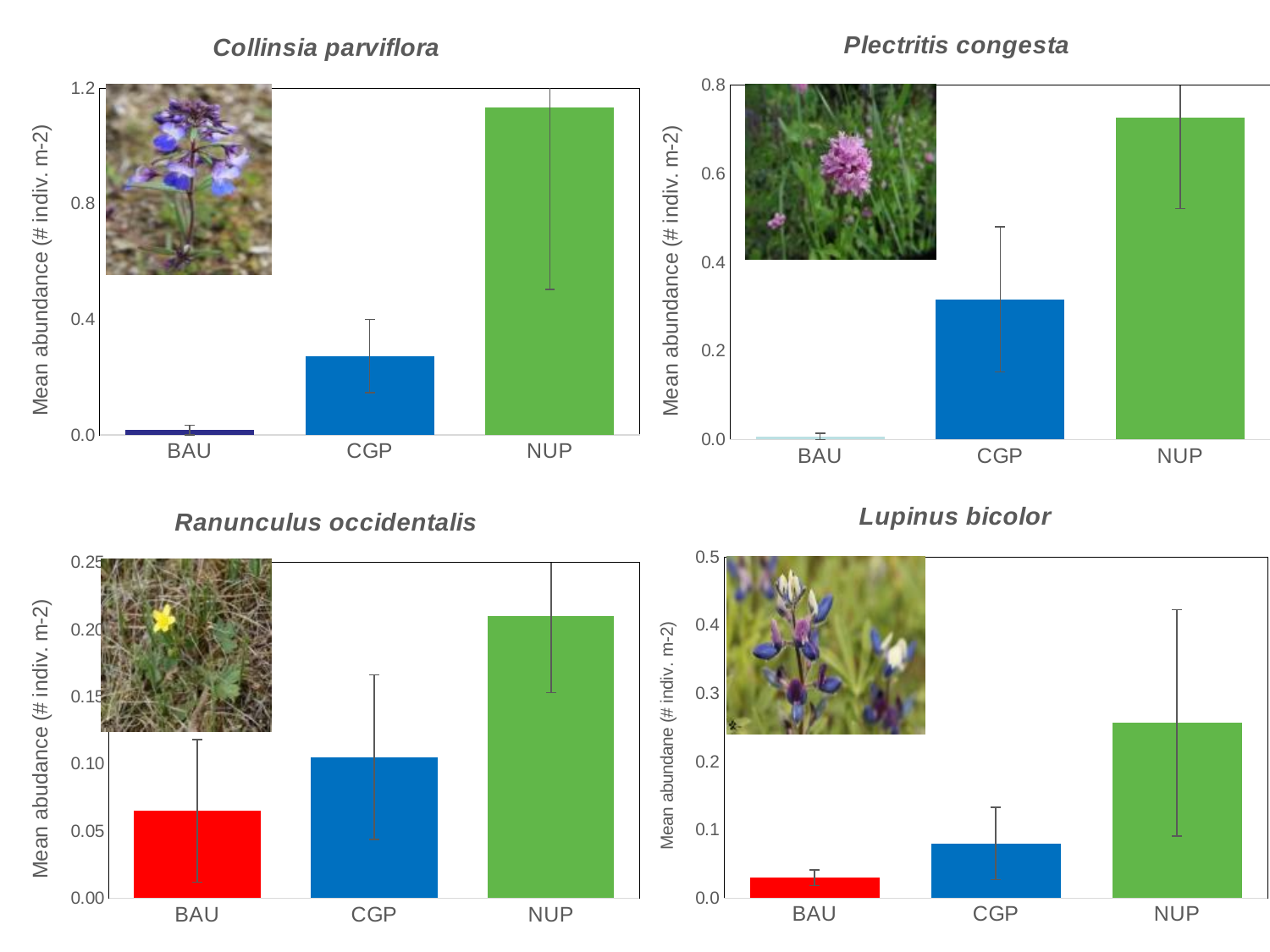
In the Collinsia parviflora chart, is the value for NUP greater or less than 0.8? greater In the Collinsia parviflora chart, which category has the highest mean abundance? NUP What kind of chart is the Ranunculus occidentalis chart? bar chart In the Ranunculus occidentalis chart, is the value for NUP greater or less than 0.15? greater How many categories are shown on the x axis of the Lupinus bicolor chart? 3 In the Plectritis congesta chart, is the value for NUP greater or less than 0.6? greater In the Lupinus bicolor chart, do the values rise or fall from BAU to NUP along the x axis? rise In the Plectritis congesta chart, which is larger, the value for CGP or the value for NUP? NUP In the Ranunculus occidentalis chart, which is larger, the value for BAU or the value for CGP? CGP In the Plectritis congesta chart, which category has the lowest mean abundance? BAU